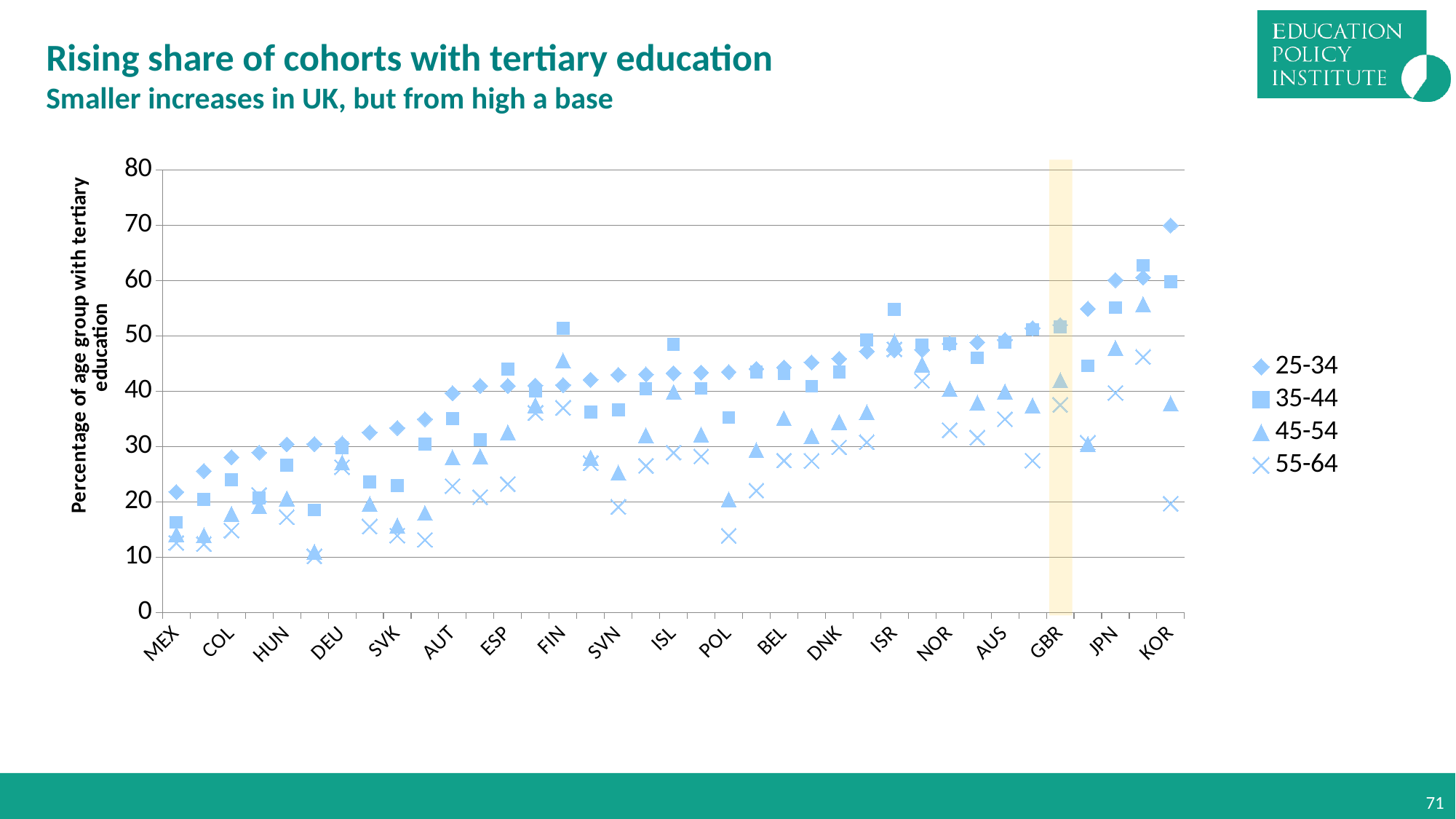
What kind of chart is shown on the slide? Scatter chart Which country has the lowest value for the 25-34 series? MEX Which country has the highest value for the 25-34 series? KOR Which is larger for GBR: the 45-54 value or the 55-64 value? 45-54 Do the 25-34 values generally rise or fall moving from MEX to KOR along the x axis? rise Is the 25-34 value for KOR greater or less than 60? greater Is the 55-64 value for POL greater or less than 20? less Is the 45-54 value for GBR greater or less than 40? greater How many series does the legend list? 4 Which country on the x axis is highlighted with a shaded band? GBR